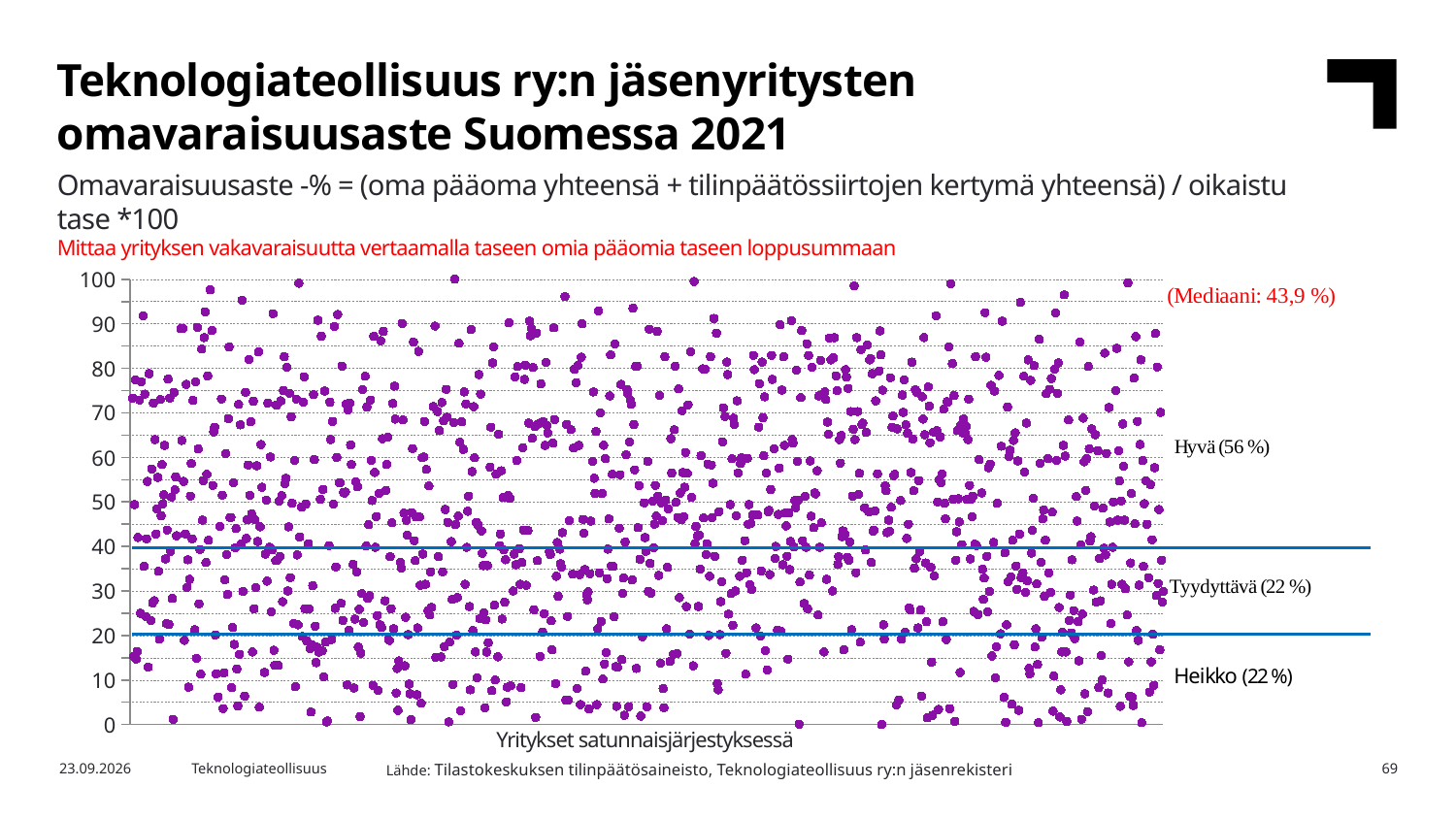
What is the maximum value shown on the y axis? 100 What is the label of the x axis? Yritykset satunnaisjärjestyksessä At which y-axis values are the two horizontal blue lines drawn? 40 and 20 What share of companies falls into the Tyydyttävä category? 22 % Which share is larger, Hyvä or Tyydyttävä? Hyvä What share of companies falls into the Heikko category? 22 % What share of companies falls into the Hyvä category? 56 % What kind of chart is shown on the slide? Scatter chart What is the difference in percentage points between the Hyvä share and the Tyydyttävä share? 34 How many categories (Hyvä, Tyydyttävä, Heikko) are labelled on the chart? 3 What is the median (Mediaani) equity ratio shown on the chart? 43,9 % Which category has the largest share of companies: Hyvä, Tyydyttävä or Heikko? Hyvä